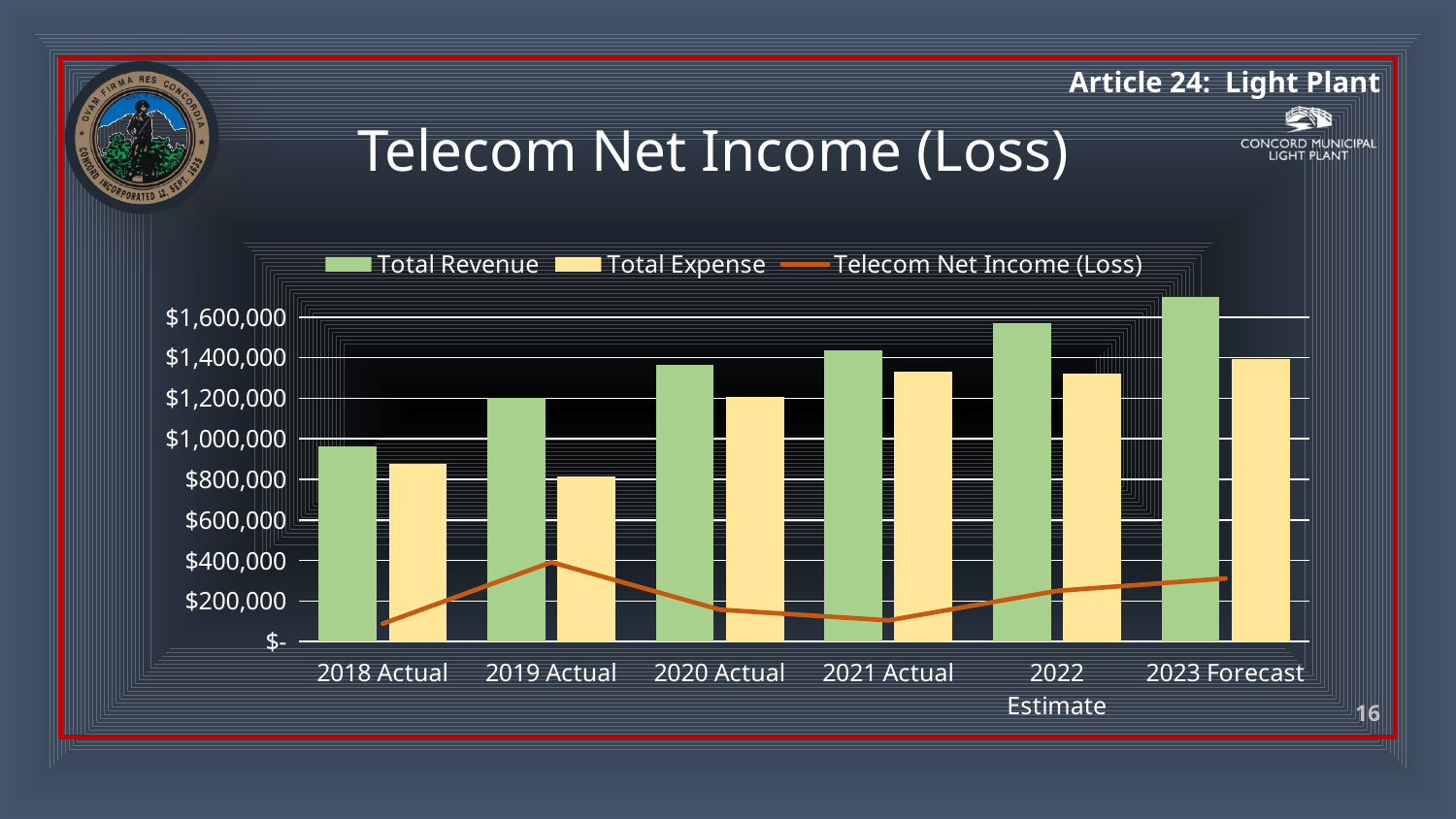
In which year does the Telecom Net Income (Loss) line reach its highest point? 2019 Actual Which year has the lowest Total Expense? 2019 Actual Does Total Revenue rise or fall from 2018 Actual to 2023 Forecast? rises How many series does the legend list? 3 Is the Total Revenue for 2023 Forecast greater or less than $1,600,000? greater Which year has the lowest Total Revenue? 2018 Actual What kind of chart is shown on the slide? bar chart with a line In 2019 Actual, which is larger, Total Revenue or Total Expense? Total Revenue Which year has the highest Total Revenue? 2023 Forecast Which year has the highest Total Expense? 2023 Forecast Is the Total Revenue for 2018 Actual greater or less than $1,000,000? less How many year categories are shown on the x axis? 6